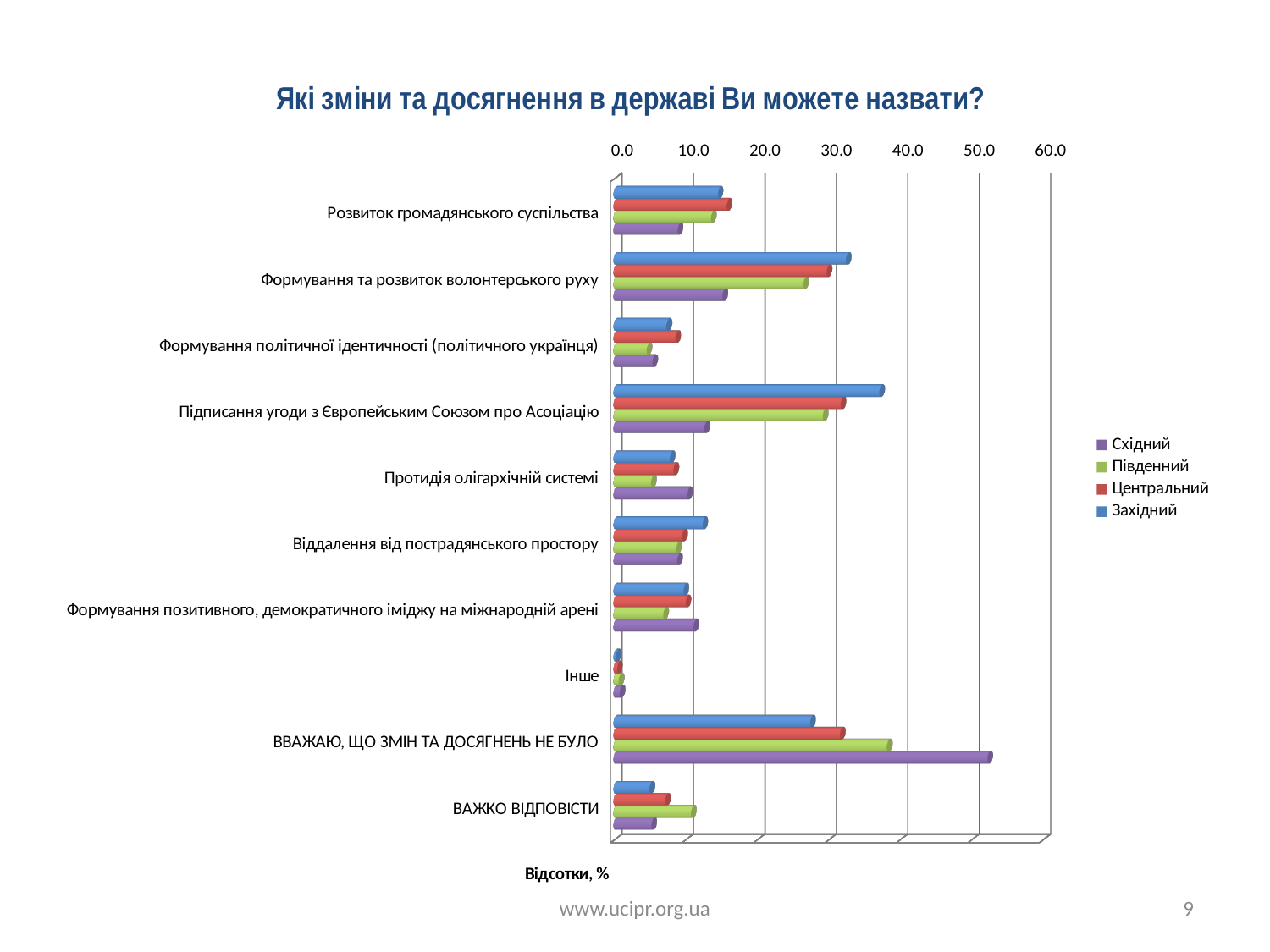
Which series are listed in the legend? Східний, Південний, Центральний, Західний How many categories (answer options) are plotted on the chart? 10 What is the label of the horizontal axis? Відсотки, % Which category has the lowest value for the Західний series? Інше Which series has the lowest value for "ВВАЖАЮ, ЩО ЗМІН ТА ДОСЯГНЕНЬ НЕ БУЛО"? Західний Is the Західний value for "Підписання угоди з Європейським Союзом про Асоціацію" greater or less than 30.0? greater Is the Східний value for "ВВАЖАЮ, ЩО ЗМІН ТА ДОСЯГНЕНЬ НЕ БУЛО" greater or less than 40.0? greater How many series does the legend list? 4 What kind of chart is shown on the slide? bar chart Which category has the highest value for the Східний series? ВВАЖАЮ, ЩО ЗМІН ТА ДОСЯГНЕНЬ НЕ БУЛО For the Західний series, which is larger: the value for "Підписання угоди з Європейським Союзом про Асоціацію" or the value for "Формування та розвиток волонтерського руху"? Підписання угоди з Європейським Союзом про Асоціацію Which series has the highest value for "Підписання угоди з Європейським Союзом про Асоціацію"? Західний